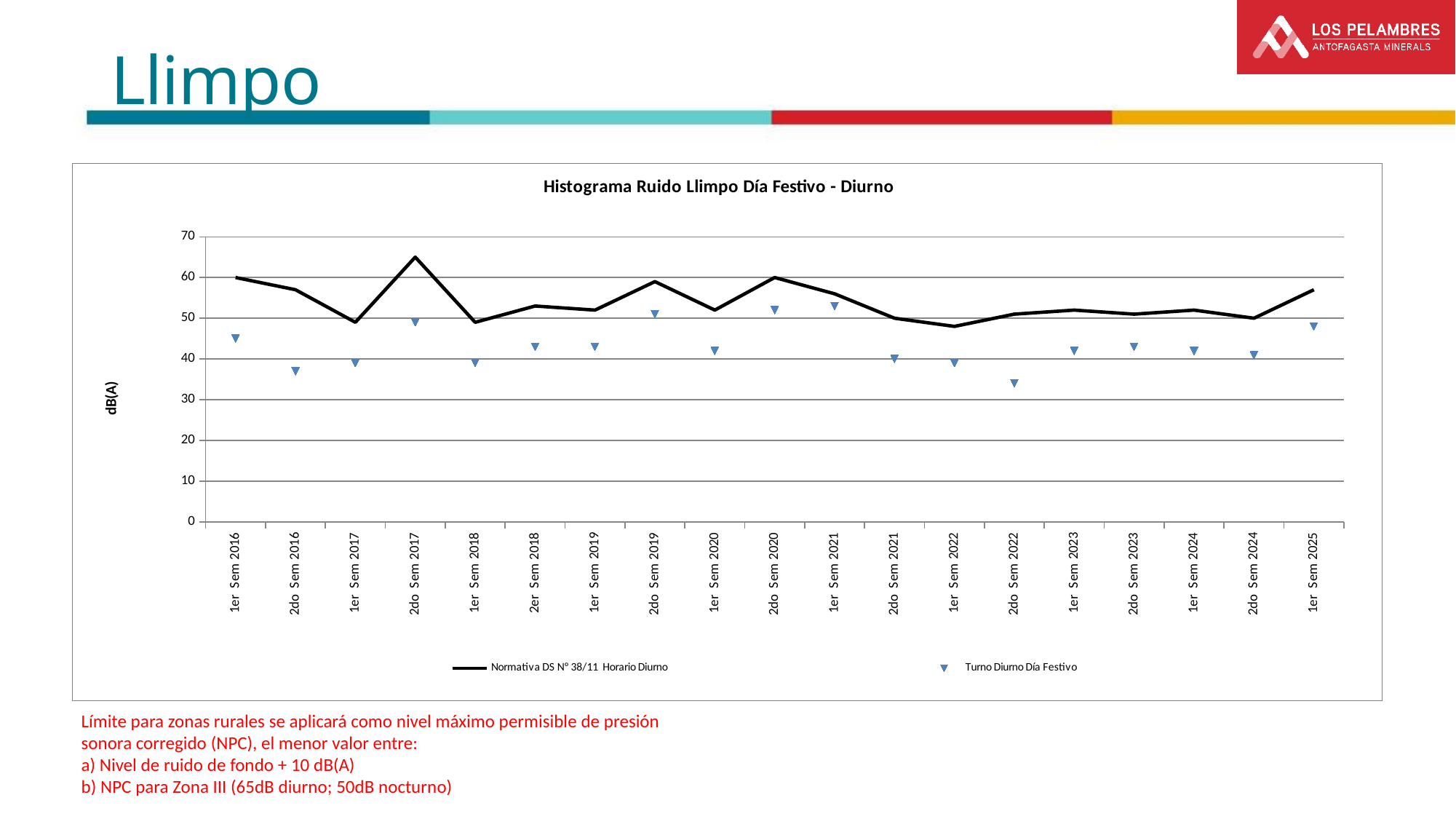
What is the title of the chart? Histograma Ruido Llimpo Día Festivo - Diurno At 1er Sem 2016, which series has the higher value: Normativa DS N° 38/11 Horario Diurno or Turno Diurno Día Festivo? Normativa DS N° 38/11 Horario Diurno Is the Turno Diurno Día Festivo value for 2do Sem 2022 greater or less than 40? less How many series does the legend list? 2 Is the Turno Diurno Día Festivo value for 2do Sem 2016 greater or less than 40? less Does the Normativa DS N° 38/11 Horario Diurno line rise or fall from 1er Sem 2016 to 1er Sem 2017? fall In which semester is the Turno Diurno Día Festivo value lowest? 2do Sem 2022 Is the Normativa DS N° 38/11 Horario Diurno value for 2do Sem 2017 greater or less than 60? greater In which semester does the Normativa DS N° 38/11 Horario Diurno line reach its highest value? 2do Sem 2017 How many semester categories are shown on the x axis? 19 What kind of chart is shown on the slide? line chart